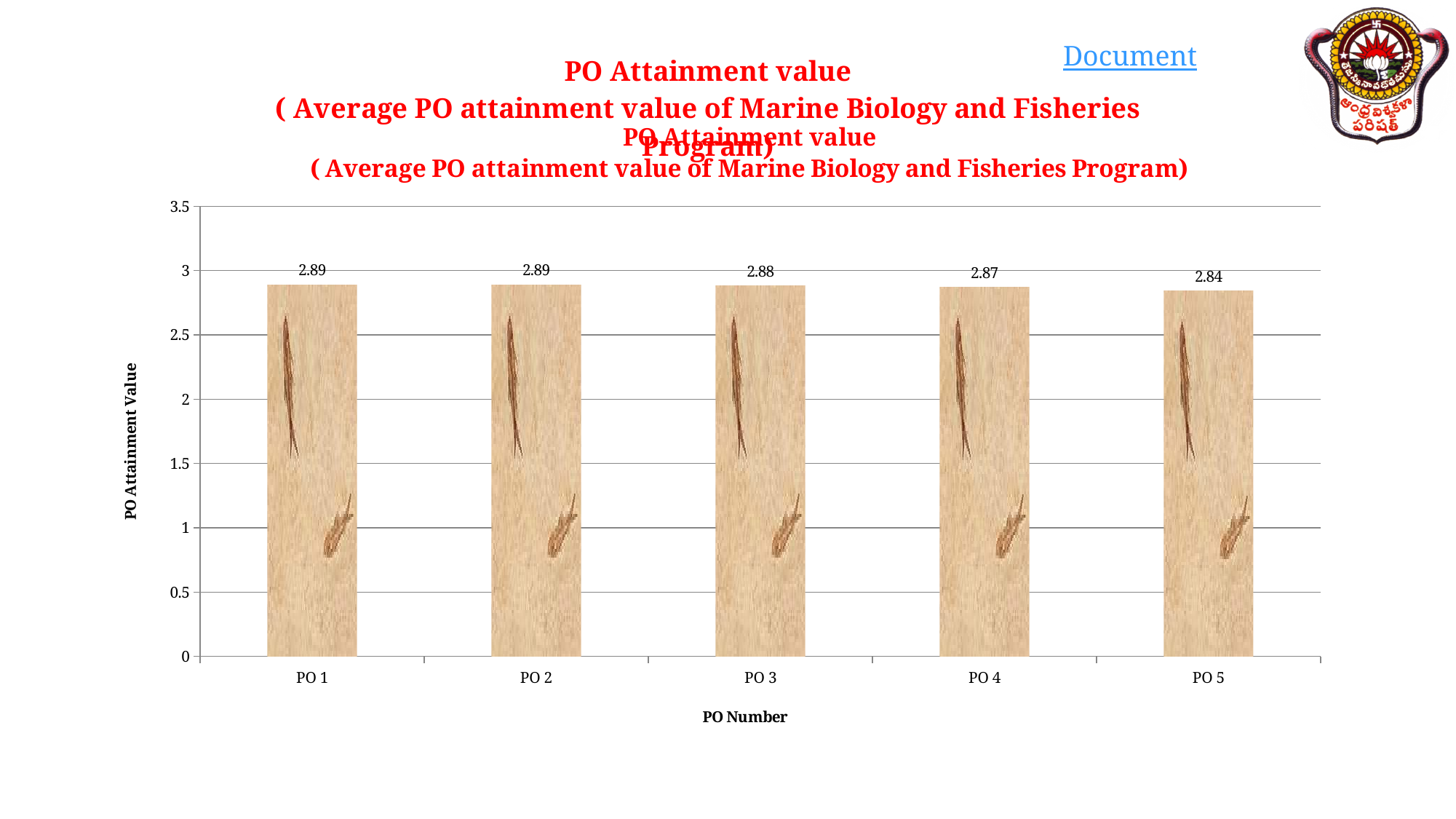
What is the PO attainment value for PO 1? 2.89 What kind of chart is shown on the slide? bar chart What is the difference between the attainment values of PO 1 and PO 5? 0.05 What is the difference between the attainment values of PO 3 and PO 4? 0.01 Which has a larger attainment value, PO 4 or PO 5? PO 4 Do the attainment values rise or fall from PO 1 to PO 5? fall What is the PO attainment value for PO 4? 2.87 Which PO has the lowest attainment value? PO 5 Is the value for PO 2 greater or less than 3? less How many PO categories are shown on the x axis? 5 What is the PO attainment value for PO 3? 2.88 What is the PO attainment value for PO 5? 2.84